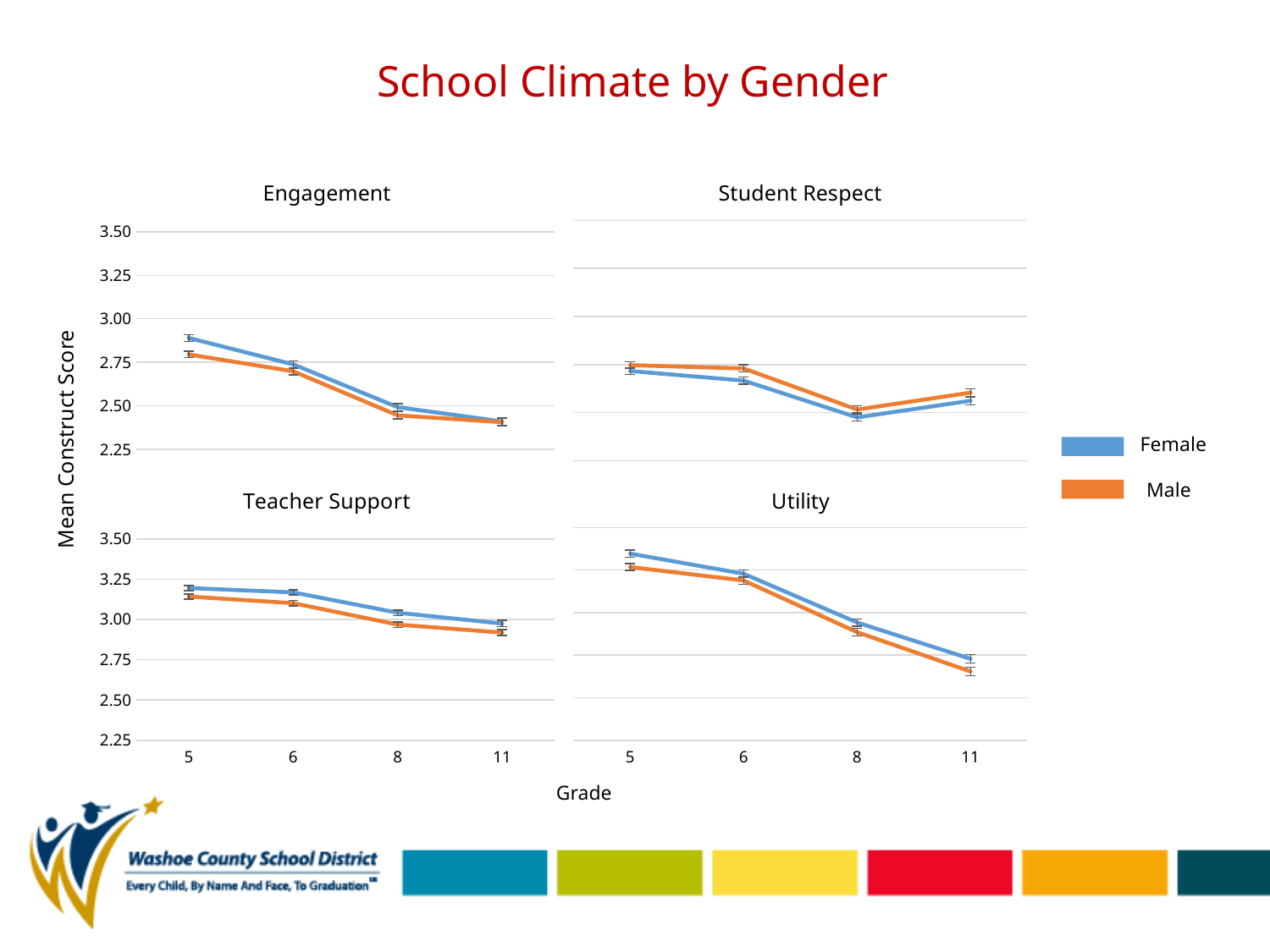
In the Engagement chart, is the Female value at grade 5 greater or less than 2.75? greater In the Utility chart, do the values rise or fall from grade 5 to grade 11? fall What is the label on the vertical axis of the charts? Mean Construct Score In the Utility chart, is the Male value at grade 11 greater or less than 2.75? less In the Engagement chart, which series has the higher value at grade 5, Female or Male? Female How many grade levels are plotted on the x axis of the Utility chart? 4 In the Utility chart, is the Female value at grade 5 greater or less than 3.25? greater What kind of chart is the Engagement chart? line chart In the Student Respect chart, do the values rise or fall from grade 8 to grade 11? rise In the Utility chart, which series has the higher value at grade 5, Female or Male? Female How many series does the legend list? 2